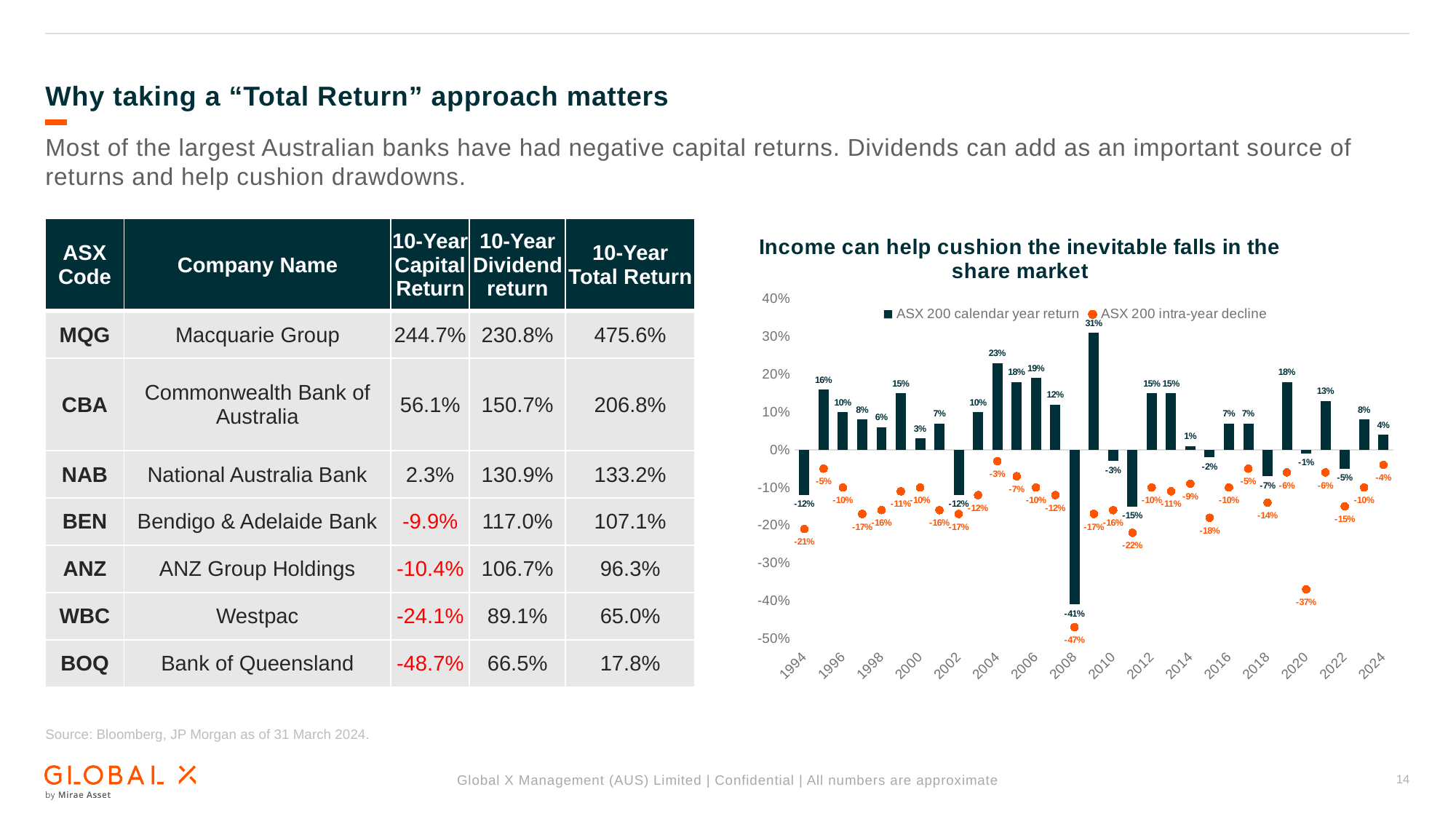
What are the two series named in the chart legend? ASX 200 calendar year return and ASX 200 intra-year decline What is the ASX 200 intra-year decline shown for 2020? -37% What is the difference between the 2008 calendar year return (-41%) and the 2008 intra-year decline (-47%)? 6 percentage points How many series does the chart legend list? 2 What is the title of the chart? Income can help cushion the inevitable falls in the share market What is the ASX 200 calendar year return shown for 2008? -41% What is the lowest ASX 200 calendar year return shown on the chart? -41% Is the ASX 200 calendar year return for 2008 greater or less than -30%? less What kind of chart is shown on the slide? A bar chart with a dot series overlaid What is the largest ASX 200 intra-year decline shown on the chart? -47% What is the highest ASX 200 calendar year return shown on the chart? 31% What is the ASX 200 intra-year decline shown for 2008? -47%